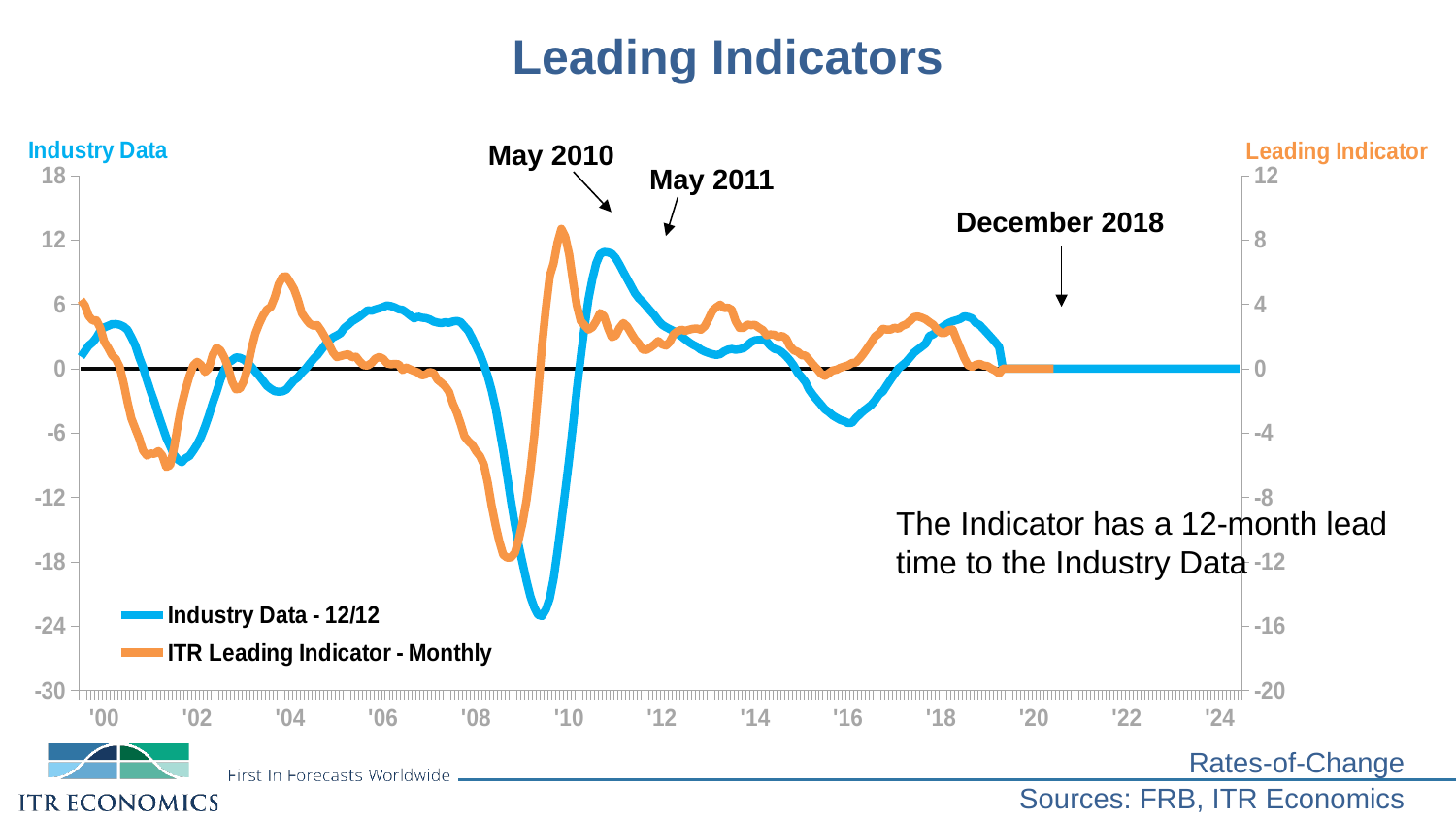
How many year labels are shown on the x axis? 13 Is the peak of the ITR Leading Indicator - Monthly line around 2010 greater or less than 8 on the right axis? greater Is the lowest value of the Industry Data - 12/12 line (around 2009) greater or less than -18 on the left axis? less Which is higher for the Industry Data - 12/12 line: the peak around 2006 or the peak around 2011? the peak around 2011 Does the Industry Data - 12/12 line rise or fall between 2009 and 2011? rise Is the trough of the ITR Leading Indicator - Monthly line around 2008-2009 greater or less than -8 on the right axis? less What kind of chart is shown on the slide? line chart What are the two series named in the legend? Industry Data - 12/12 and ITR Leading Indicator - Monthly How many series does the legend list? 2 What is the title of the chart? Leading Indicators Around which year does the Industry Data - 12/12 line reach its lowest point? 2009